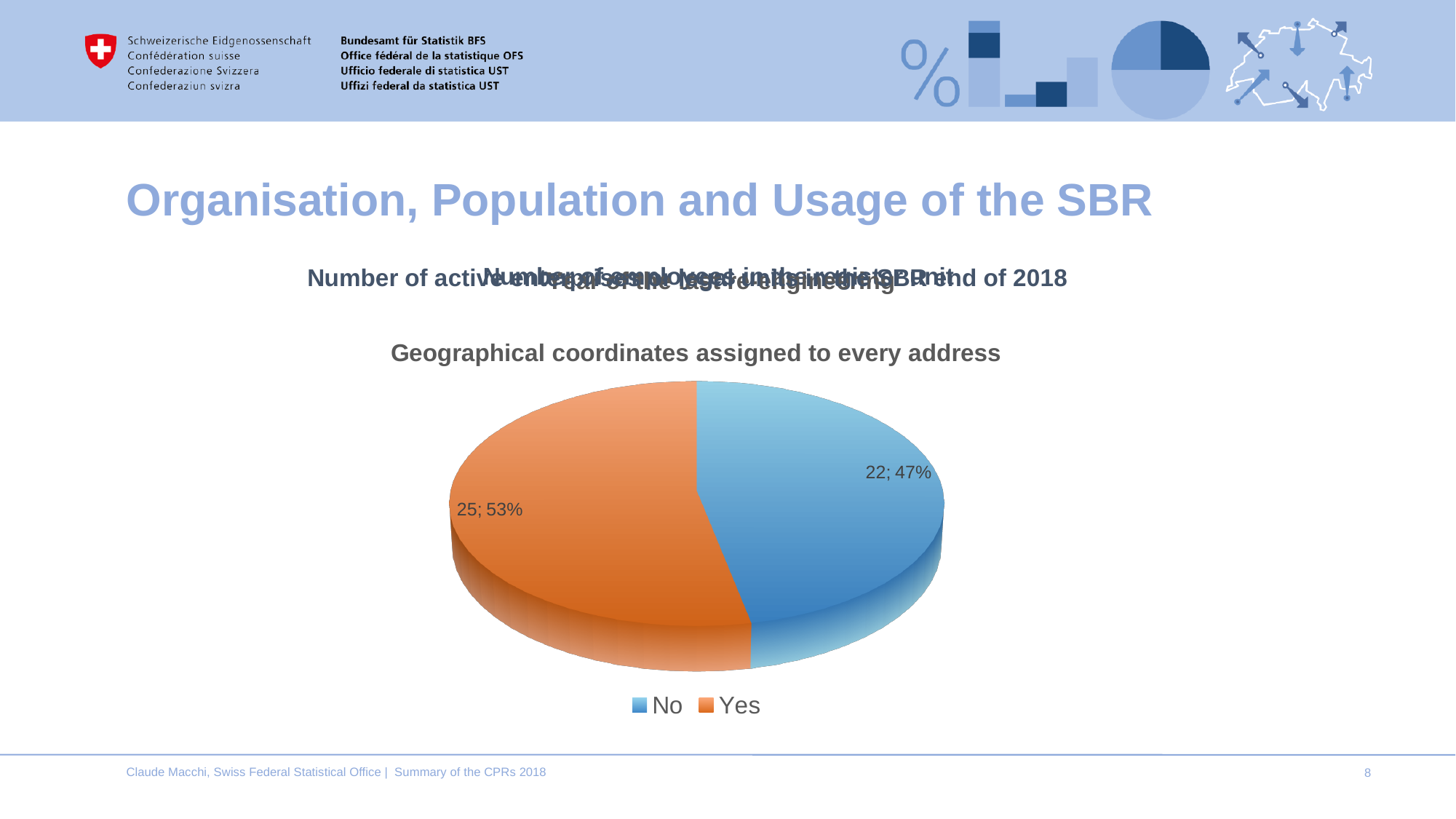
What percentage share does the 'No' slice have in the 'Geographical coordinates assigned to every address' pie chart? 47% What is the total of the two slices in the 'Geographical coordinates assigned to every address' pie chart? 47 How many slices does the 'Geographical coordinates assigned to every address' pie chart have? 2 What percentage share does the 'Yes' slice have in the 'Geographical coordinates assigned to every address' pie chart? 53% How many countries answered 'Yes' in the 'Geographical coordinates assigned to every address' pie chart? 25 How many entries does the legend of the 'Geographical coordinates assigned to every address' pie chart list? 2 What kind of chart is shown under the title 'Geographical coordinates assigned to every address'? pie chart Which slice is larger in the 'Geographical coordinates assigned to every address' pie chart, 'Yes' or 'No'? Yes What colour is the 'Yes' slice in the 'Geographical coordinates assigned to every address' pie chart? orange How many countries answered 'No' in the 'Geographical coordinates assigned to every address' pie chart? 22 Which category has the smallest slice in the 'Geographical coordinates assigned to every address' pie chart? No What is the difference between the 'Yes' and 'No' counts in the 'Geographical coordinates assigned to every address' pie chart? 3